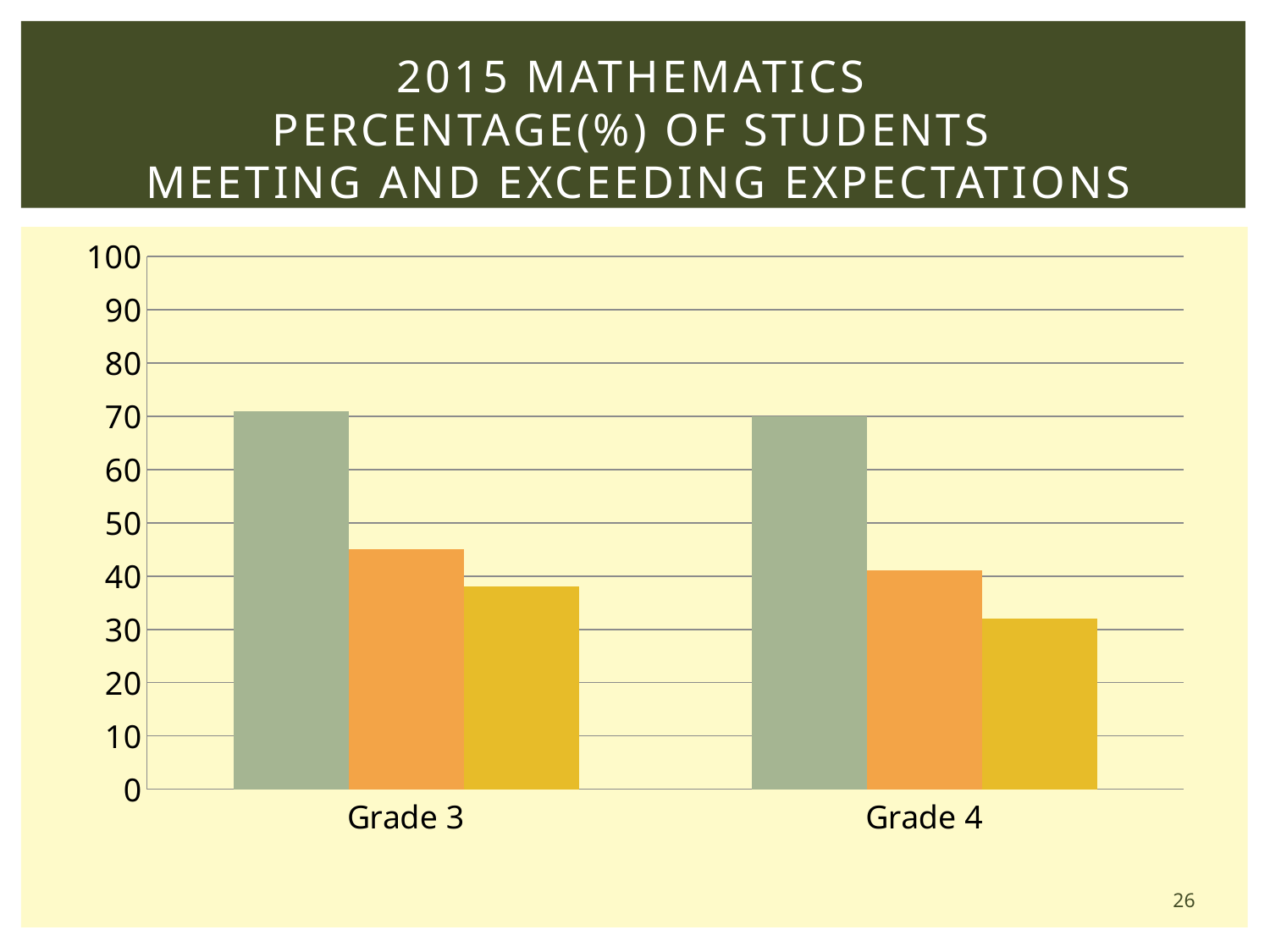
Is the value of the yellow bar for Grade 4 greater or less than 40? less Is the value of the gray bar for Grade 4 greater or less than 60? greater Which grade has the larger orange bar, Grade 3 or Grade 4? Grade 3 How many bars are plotted for each grade category? 3 What kind of chart is shown on the slide? bar chart Which grade has the larger yellow bar, Grade 3 or Grade 4? Grade 3 Is the value of the orange bar for Grade 3 greater or less than 40? greater Which coloured bar is the tallest within the Grade 4 group? the gray bar How many grade categories are shown on the x axis? 2